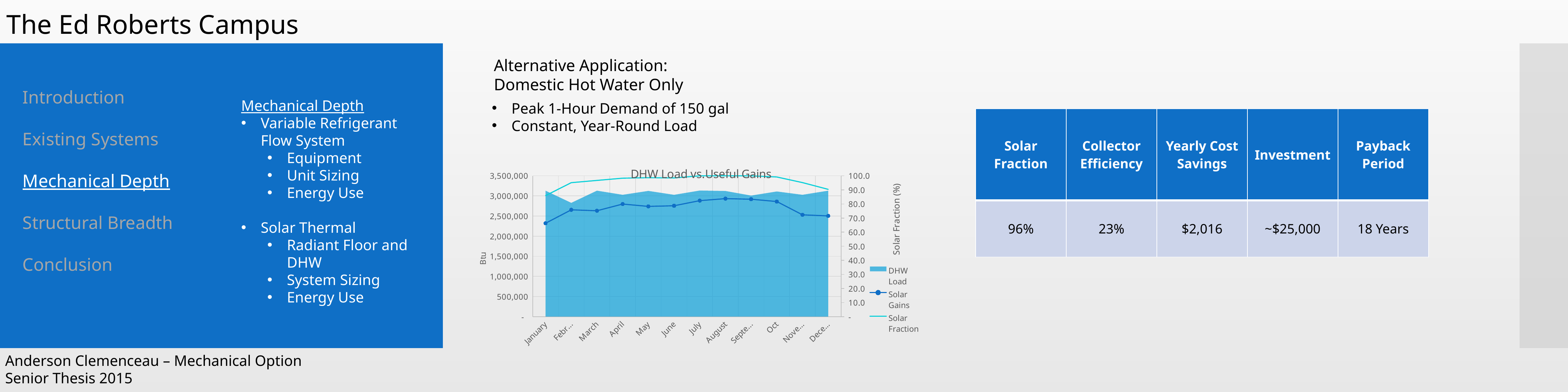
Which is larger, the Solar Gains value for January or for July? July What is the label of the right-hand vertical axis of the chart? Solar Fraction (%) How many series does the chart's legend list? 3 Is the DHW Load value for May greater or less than 2,500,000? greater Is the Solar Fraction value for March greater or less than 90.0? greater Is the Solar Gains value for August greater or less than 2,500,000? greater How many months are shown along the x axis of the chart? 12 In which month is the Solar Gains value lowest? January Do the Solar Gains values rise or fall from January to August? rise Do the Solar Gains values rise or fall from October to November? fall What is the title of the chart on the slide? DHW Load vs.Useful Gains